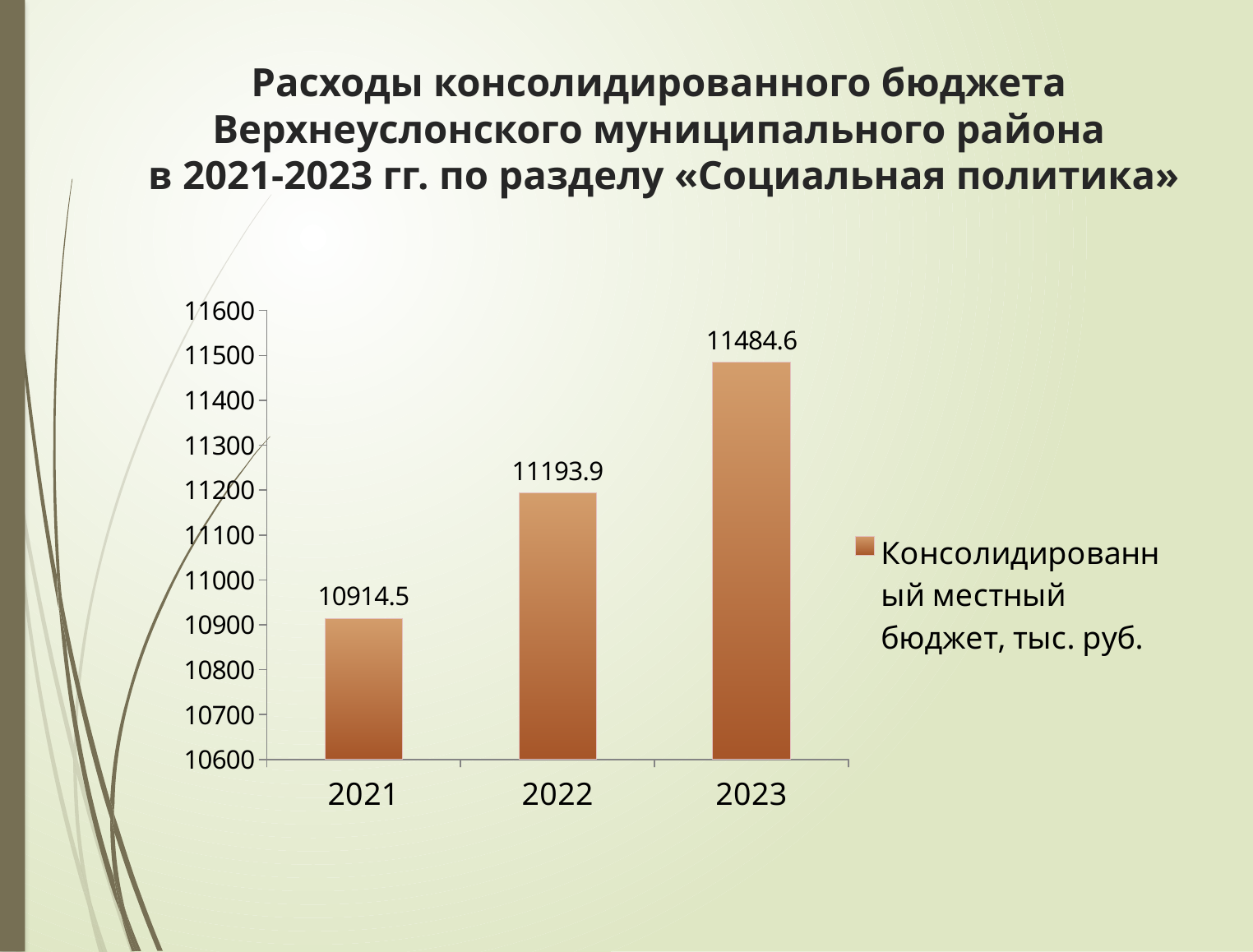
How many years are shown on the x axis? 3 What is the difference between the values for 2023 and 2021? 570.1 What is the difference between the values for 2022 and 2021? 279.4 What is the value for 2021? 10914.5 Which is larger, the value for 2022 or the value for 2023? 2023 Which year has the highest value? 2023 What is the value for 2023? 11484.6 Which year has the lowest value? 2021 Do the values rise or fall from 2021 to 2023? rise What is the value for 2022? 11193.9 Is the value for 2021 greater or less than 11000? less What kind of chart is shown on the slide? bar chart